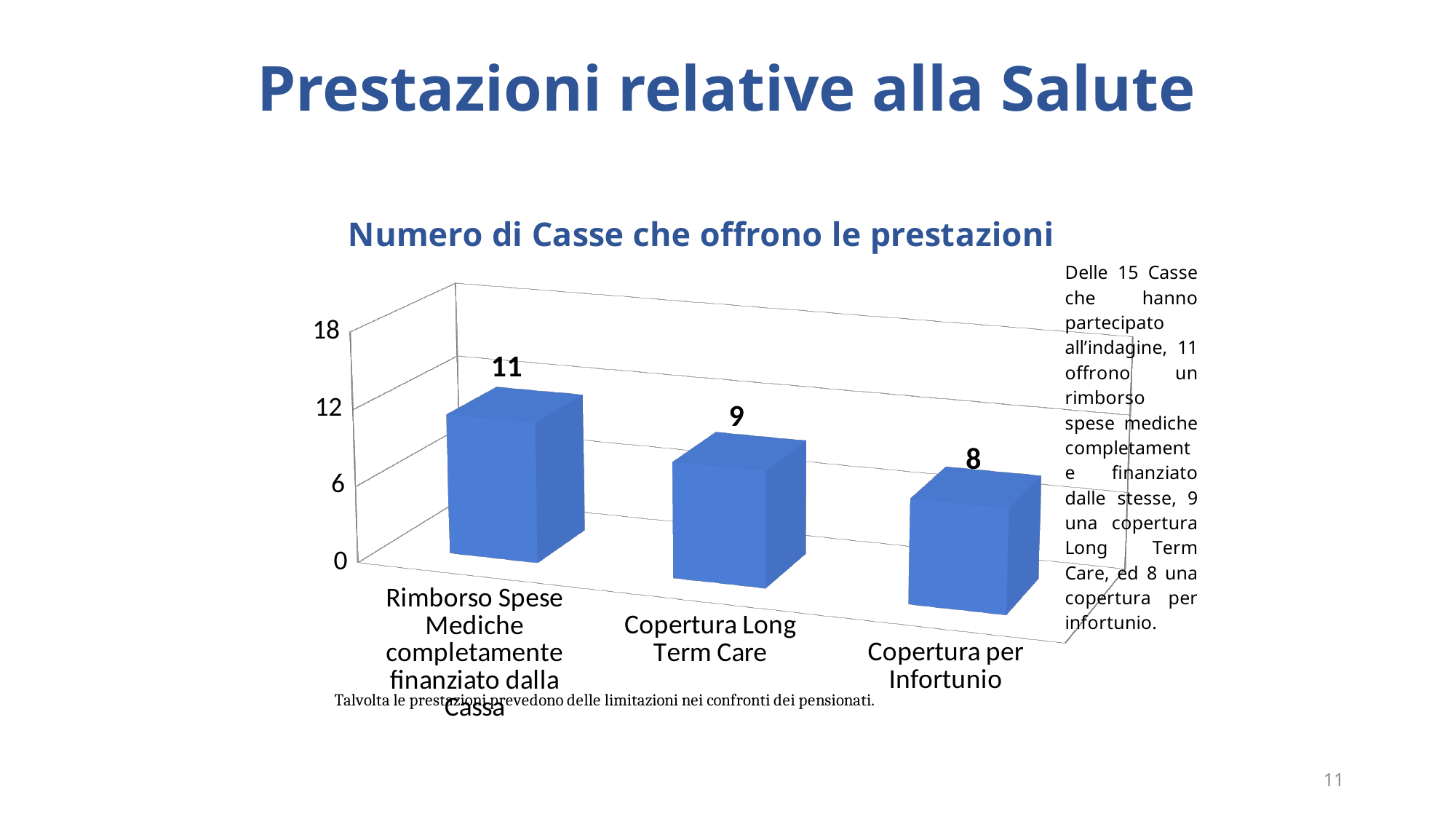
Is the value for Rimborso Spese Mediche completamente finanziato dalla Cassa greater or less than 6? greater What is the difference between the values for Rimborso Spese Mediche completamente finanziato dalla Cassa and Copertura per Infortunio? 3 What is the difference between the values for Copertura Long Term Care and Copertura per Infortunio? 1 What is the value for Copertura per Infortunio? 8 What is the title of the chart? Numero di Casse che offrono le prestazioni Which category has the highest value? Rimborso Spese Mediche completamente finanziato dalla Cassa Which is larger, the value for Copertura Long Term Care or the value for Copertura per Infortunio? Copertura Long Term Care What kind of chart is shown on the slide? bar chart Which category has the lowest value? Copertura per Infortunio How many categories are shown in the chart? 3 What is the value for Rimborso Spese Mediche completamente finanziato dalla Cassa? 11 What is the value for Copertura Long Term Care? 9